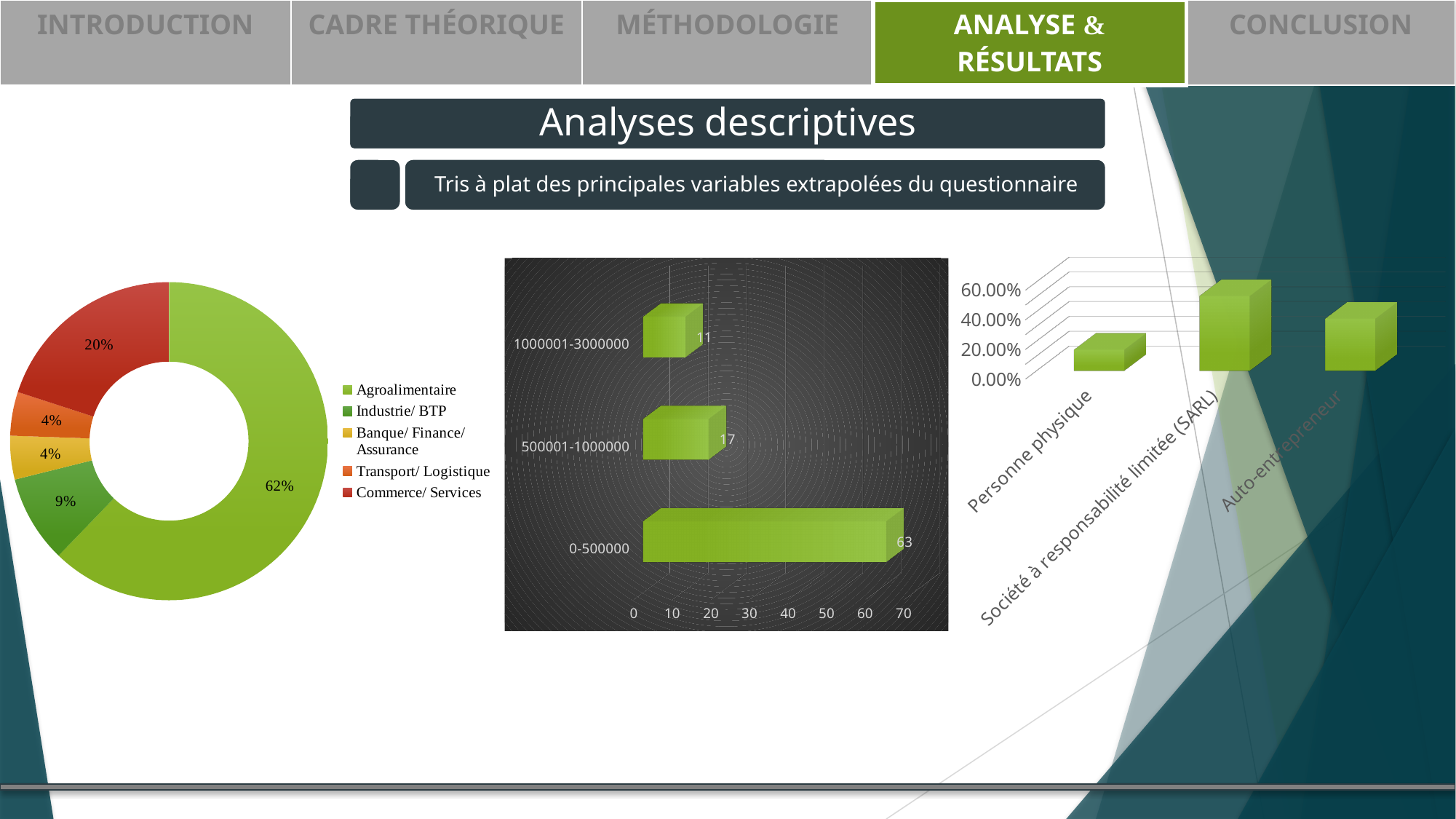
In the middle chart with the dark background, what is the value for 0-500000? 63 In the doughnut chart on the left, what is the difference between the shares of Commerce/ Services and Industrie/ BTP? 11% In the middle chart with the dark background, which category has the lowest value? 1000001-3000000 What kind of chart is the middle chart with the dark background? Bar chart In the middle chart with the dark background, what is the value for 1000001-3000000? 11 In the doughnut chart on the left, how many categories does the legend list? 5 In the doughnut chart on the left, what share does Commerce/ Services have? 20% In the chart on the right, is the value for Société à responsabilité limitée (SARL) greater or less than 40.00%? greater In the doughnut chart on the left, which category has the largest share? Agroalimentaire In the doughnut chart on the left, what share does Agroalimentaire have? 62% In the chart on the right, is the value for Personne physique greater or less than 20.00%? less In the middle chart with the dark background, what is the difference between the values for 0-500000 and 500001-1000000? 46